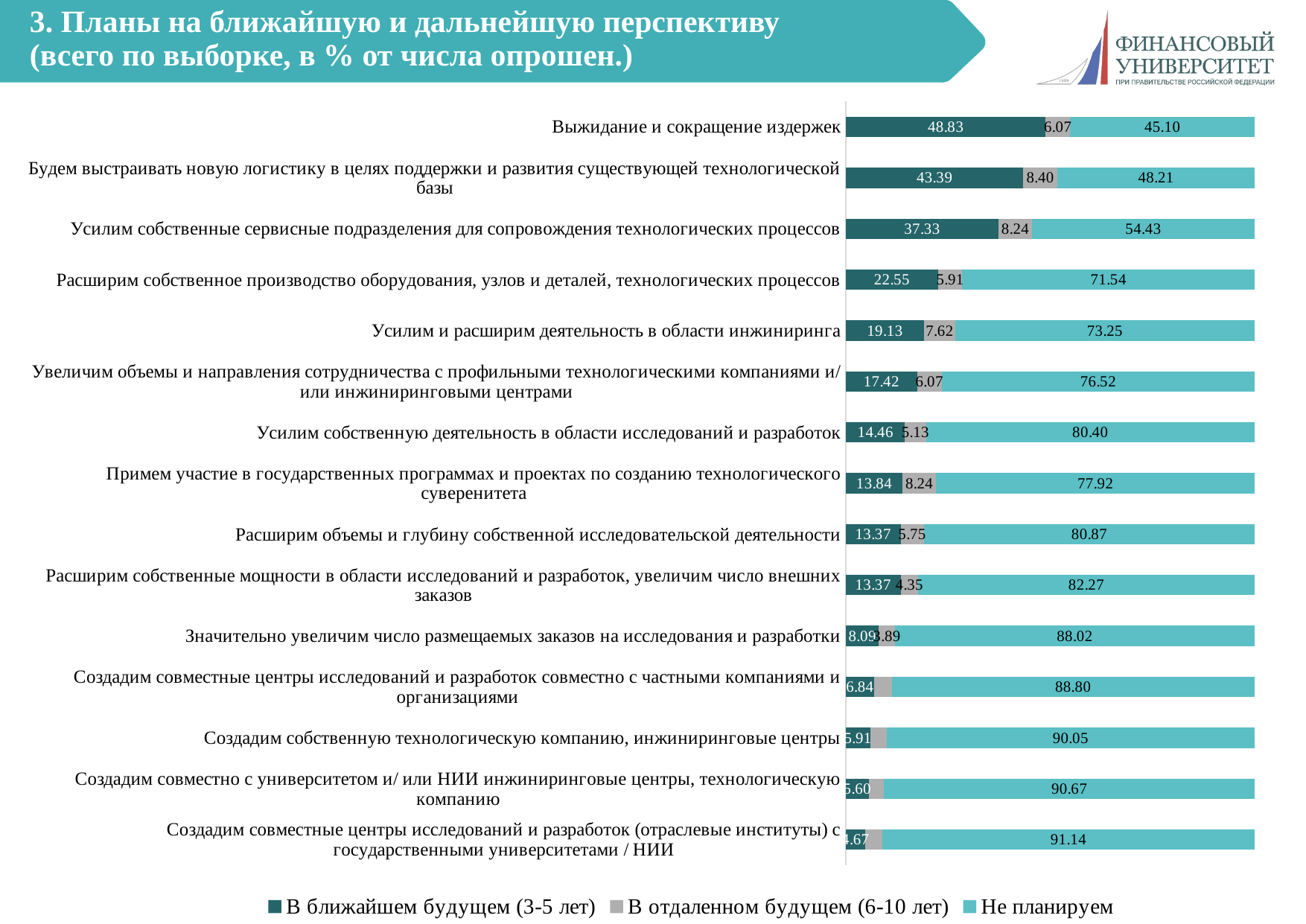
Which category has the highest value for "Не планируем"? Создадим совместные центры исследований и разработок (отраслевые институты) с государственными университетами / НИИ What is the value of "Не планируем" for "Усилим и расширим деятельность в области инжиниринга"? 73.25 What is the total of the stacked bar for "Выжидание и сокращение издержек"? 100.00 How many series does the legend list? 3 What is the value of "В отдаленном будущем (6-10 лет)" for "Будем выстраивать новую логистику в целях поддержки и развития существующей технологической базы"? 8.40 What is the value of "В ближайшем будущем (3-5 лет)" for "Выжидание и сокращение издержек"? 48.83 Which category has the lowest value for "В ближайшем будущем (3-5 лет)"? Создадим совместные центры исследований и разработок (отраслевые институты) с государственными университетами / НИИ Which is larger: the "В ближайшем будущем (3-5 лет)" value for "Расширим собственное производство оборудования, узлов и деталей, технологических процессов" or for "Усилим и расширим деятельность в области инжиниринга"? Расширим собственное производство оборудования, узлов и деталей, технологических процессов What is the difference between the "Не планируем" values for "Усилим собственные сервисные подразделения для сопровождения технологических процессов" and "Выжидание и сокращение издержек"? 9.33 Which legend entry is shown in the lightest teal colour? Не планируем What kind of chart is shown on the slide? Stacked bar chart How many categories (plans) are plotted on the chart? 15